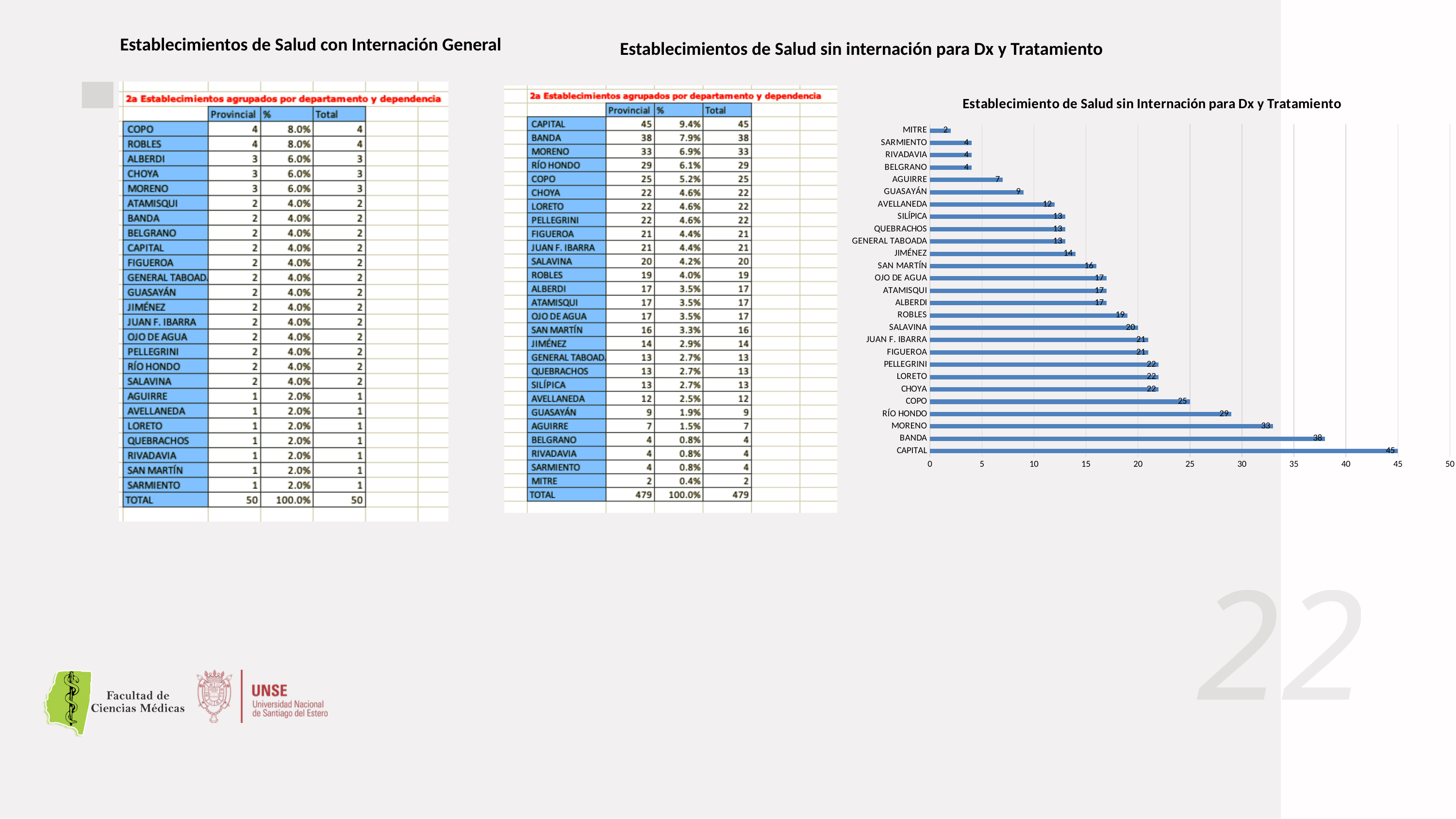
What is the difference between the values for CAPITAL and MITRE in the chart? 43 Is the value for GUASAYÁN in the chart greater or less than 10? less What type of chart is shown on the slide? bar chart Which has a larger value in the chart, COPO or SALAVINA? COPO What is the value for JIMÉNEZ in the chart? 14 What is the value for CAPITAL in the chart? 45 Which category has the lowest value in the chart? MITRE How many categories are plotted in the chart? 27 What is the difference between the values for BANDA and MORENO in the chart? 5 What is the value for RÍO HONDO in the chart? 29 What is the title of the chart? Establecimiento de Salud sin Internación para Dx y Tratamiento Which category has the highest value in the chart? CAPITAL